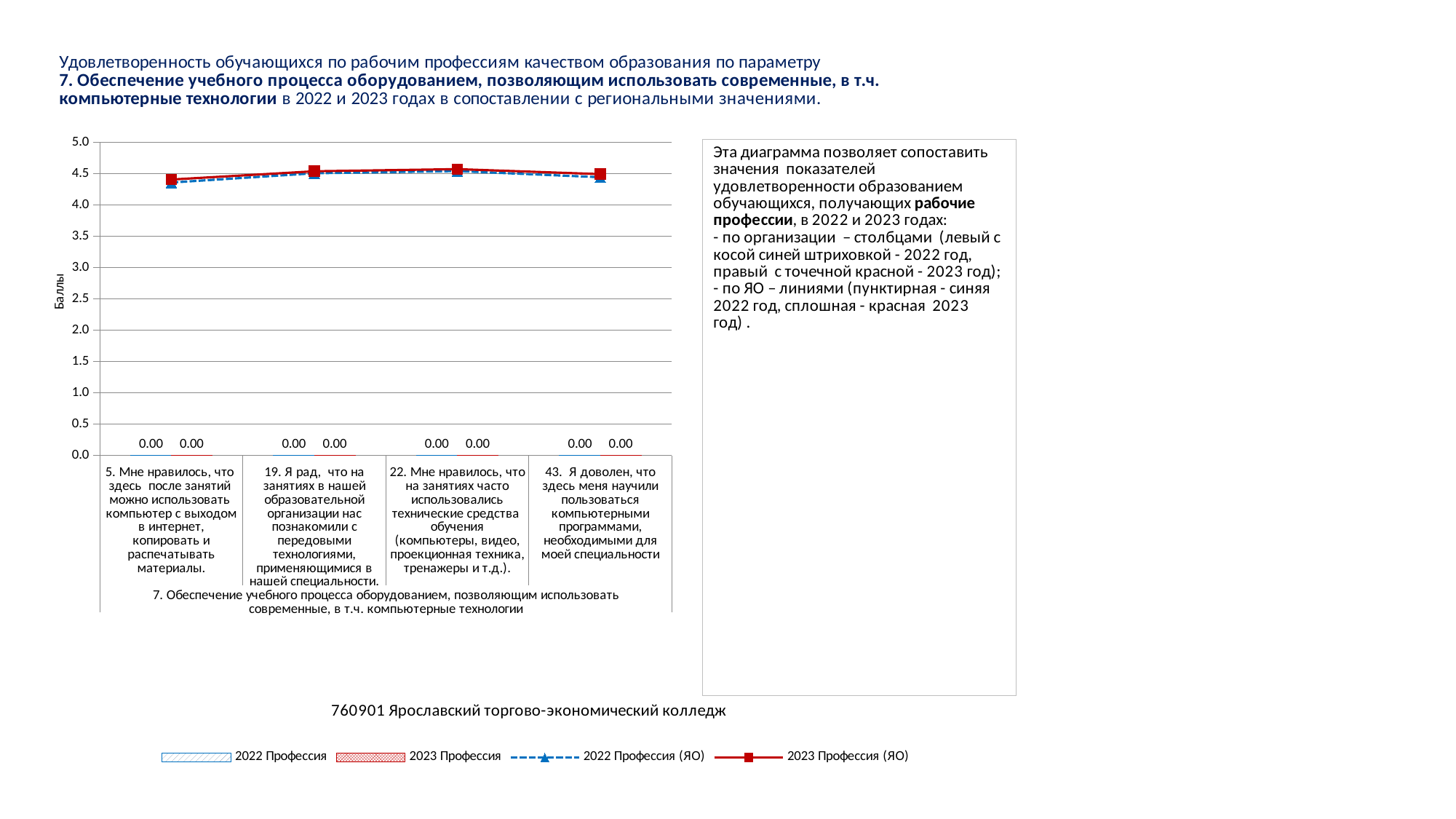
What is the highest value shown on the vertical axis of the chart? 5.0 What kind of chart is shown on the slide? bar and line chart Is the value of the 2022 Профессия (ЯО) line for category 43 greater or less than 3.5? greater What is the data label for the 2022 Профессия bar in category 5 (Мне нравилось, что здесь после занятий можно использовать компьютер...)? 0.00 Is the value of the 2023 Профессия (ЯО) line for category 19 greater or less than 4.0? greater Is the value of the 2023 Профессия (ЯО) line for category 22 greater or less than 4.0? greater What is the data label for the 2023 Профессия bar in category 43 (Я доволен, что здесь меня научили пользоваться компьютерными программами...)? 0.00 What is the label of the vertical axis of the chart? Баллы What is the total of the 2022 Профессия and 2023 Профессия bars in category 22? 0.00 How many series does the chart legend list? 4 How many categories (questions) are shown along the x axis of the chart? 4